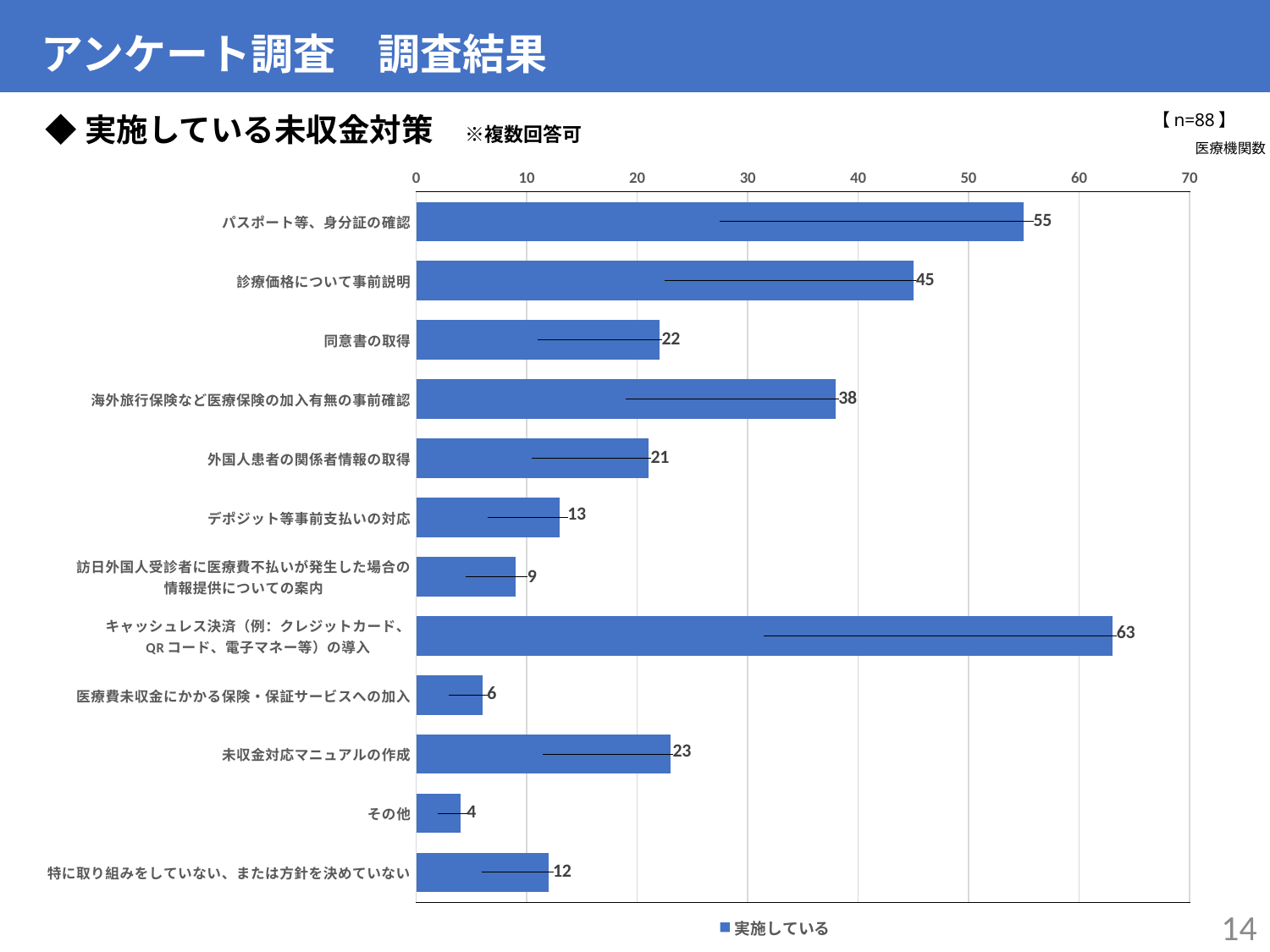
What is the value for パスポート等、身分証の確認? 55 How many categories are shown in the chart? 12 How many series does the legend list? 1 What kind of chart is shown on the slide? bar chart Which is larger, the value for 同意書の取得 or the value for 未収金対応マニュアルの作成? 未収金対応マニュアルの作成 What is the difference between the values for 診療価格について事前説明 and 海外旅行保険など医療保険の加入有無の事前確認? 7 Which category has the lowest value? その他 Which category has the highest value? キャッシュレス決済（例：クレジットカード、QRコード、電子マネー等）の導入 What is the value for 医療費未収金にかかる保険・保証サービスへの加入? 6 What is the legend entry shown below the chart? 実施している What is the value for デポジット等事前支払いの対応? 13 Is the value for 外国人患者の関係者情報の取得 greater or less than 30? less